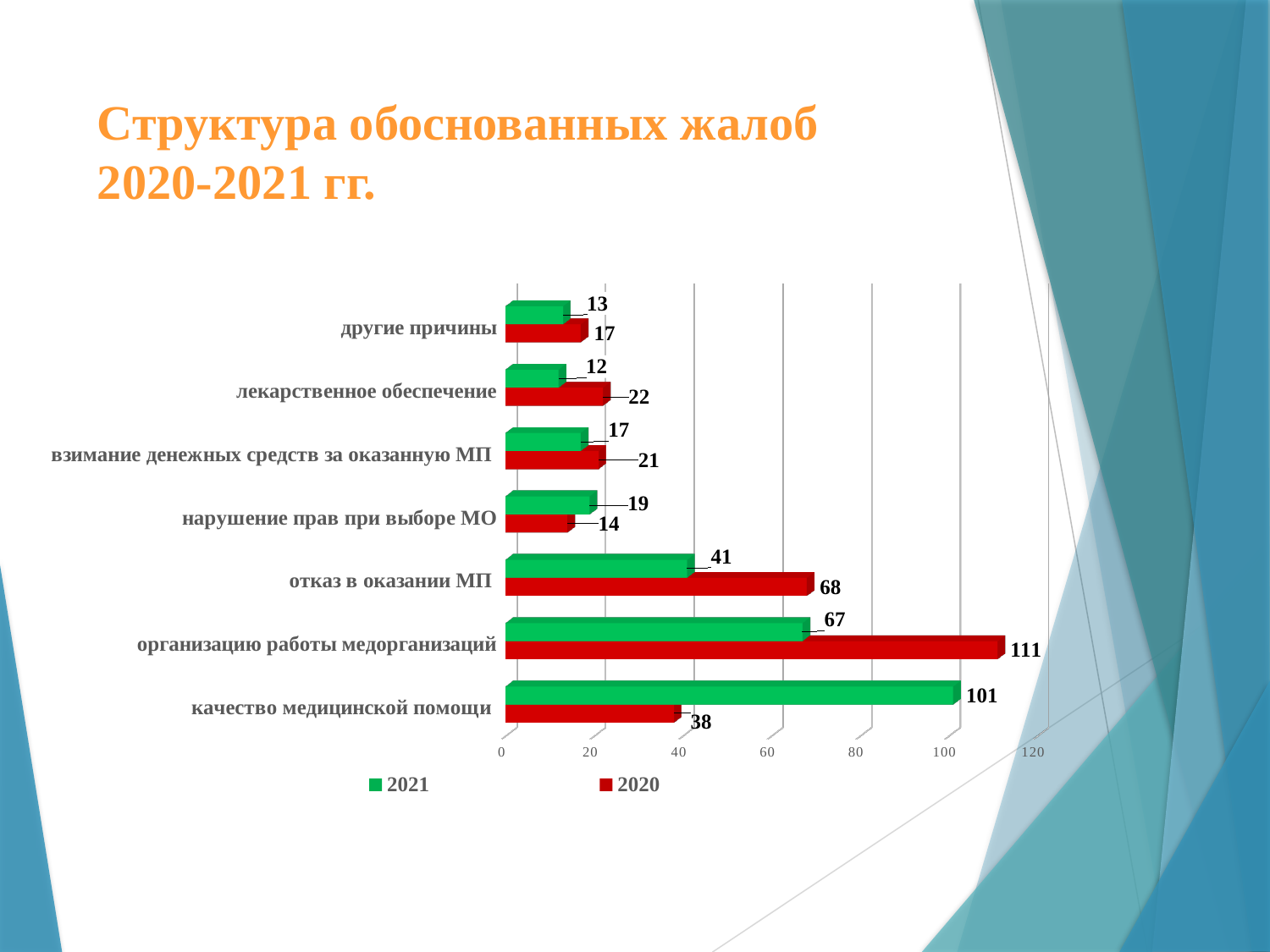
What is the 2020 value for организацию работы медорганизаций? 111 Which category has the lowest 2021 value? лекарственное обеспечение Is the 2020 value for отказ в оказании МП greater or less than 60? greater What is the difference between the 2020 and 2021 values for отказ в оказании МП? 27 How many series does the legend list? 2 For качество медицинской помощи, which year has the larger value, 2020 or 2021? 2021 Which colour represents the 2021 series? green What is the 2020 value for лекарственное обеспечение? 22 How many categories are shown on the chart? 7 What is the 2021 value for качество медицинской помощи? 101 What kind of chart is shown on the slide? bar chart Which category has the highest 2020 value? организацию работы медорганизаций